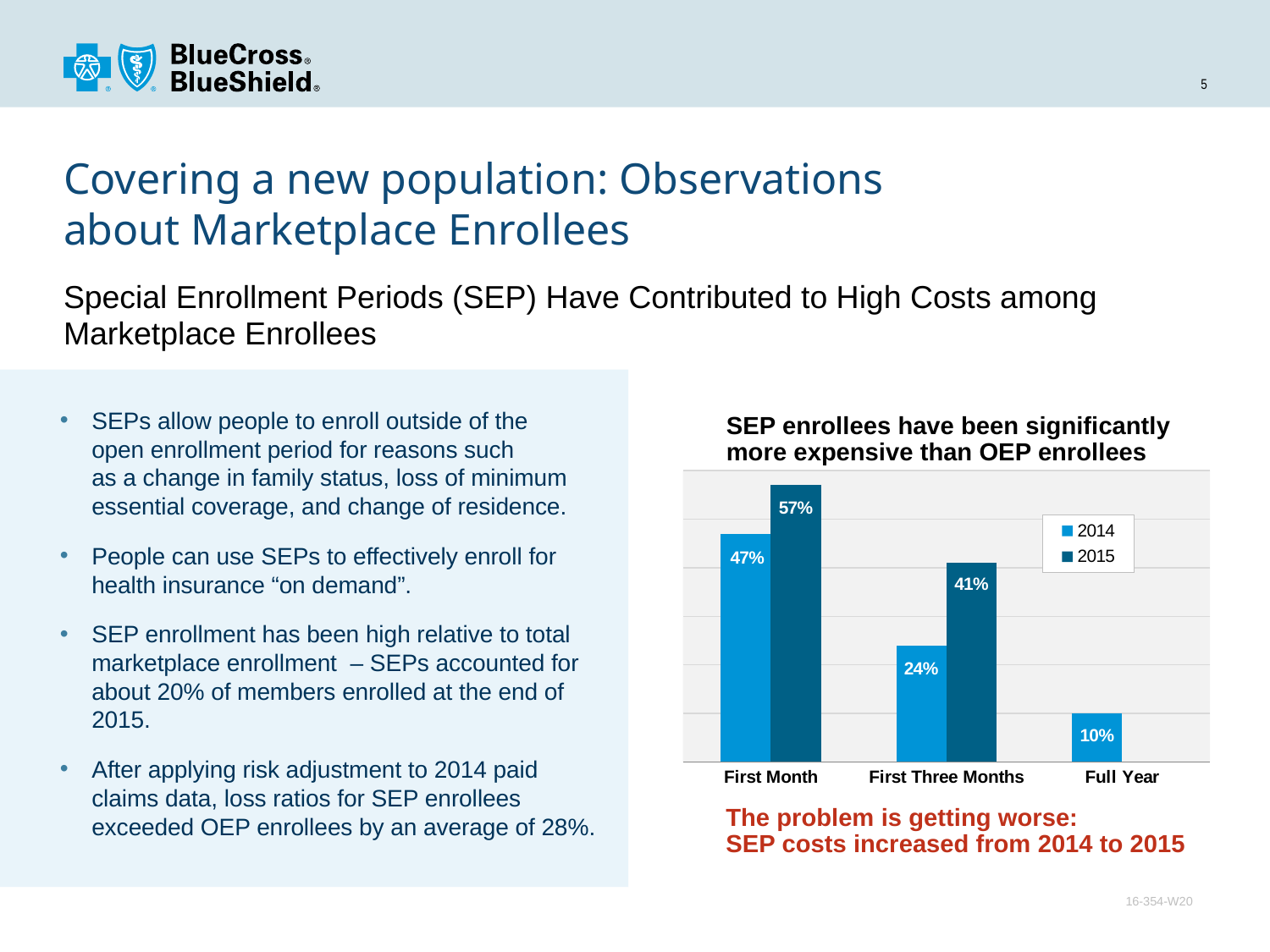
Which category has the lowest 2014 value? Full Year Which category has the highest 2015 value? First Month What kind of chart is shown on the slide? Bar chart What is the difference between the 2015 and 2014 values for First Three Months? 17% What is the 2014 value for Full Year? 10% What is the 2014 value for First Month? 47% How many series does the legend list? 2 Which is larger for First Month: the 2014 value or the 2015 value? 2015 What is the 2015 value for First Month? 57% What is the 2014 value for First Three Months? 24% How many categories are shown on the x axis? 3 What is the 2015 value for First Three Months? 41%